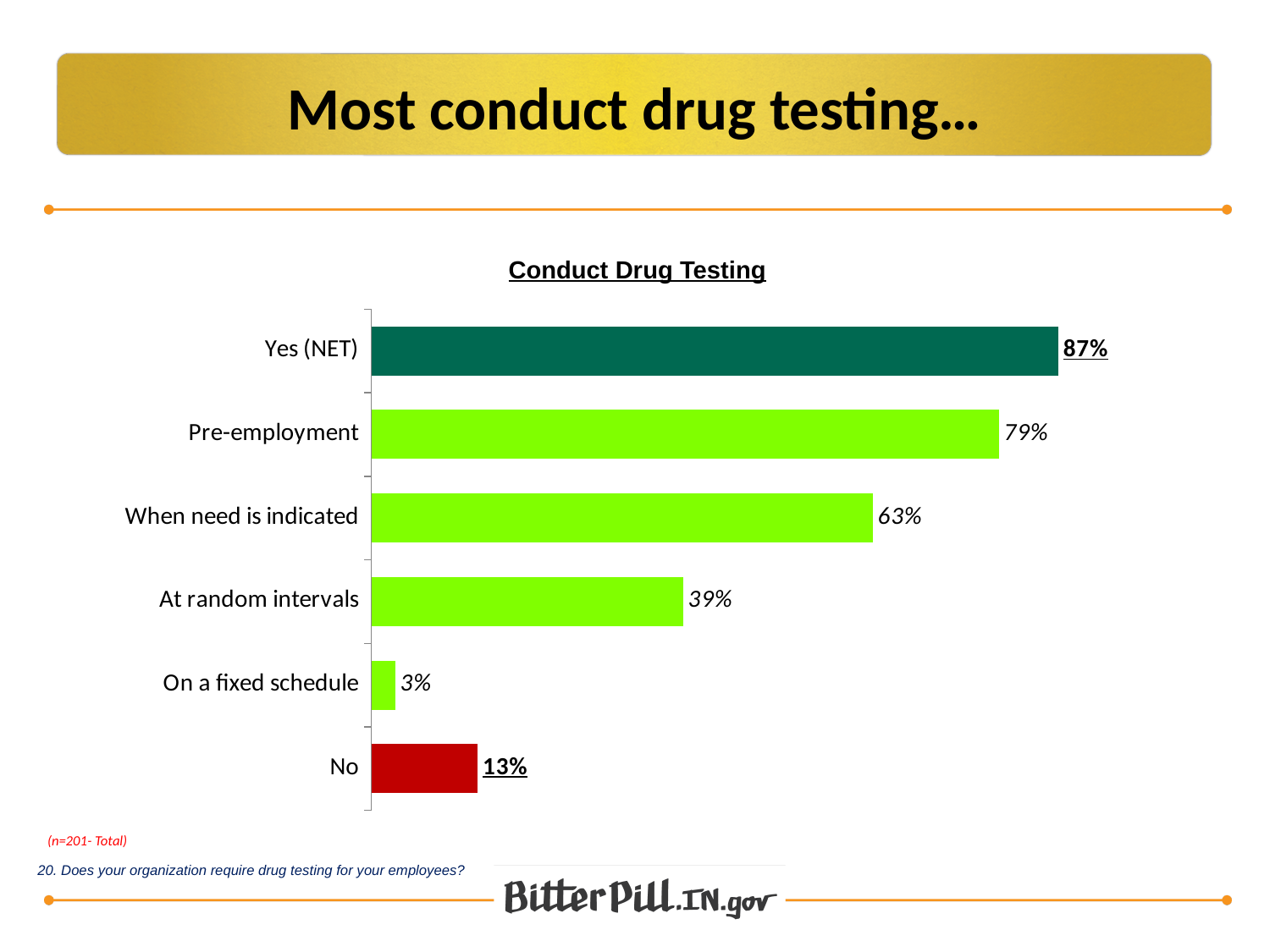
What is the difference between the values for Yes (NET) and No? 74% What kind of chart is shown on the slide? Bar chart Which category has the lowest value? On a fixed schedule How many categories are shown in the chart? 6 Which is larger, the value for At random intervals or the value for No? At random intervals What is the value for Pre-employment? 79% What is the value for No? 13% What is the difference between the values for Pre-employment and When need is indicated? 16% What is the title of the chart? Conduct Drug Testing What is the value for When need is indicated? 63% Which category has the highest value? Yes (NET) What is the value for At random intervals? 39%